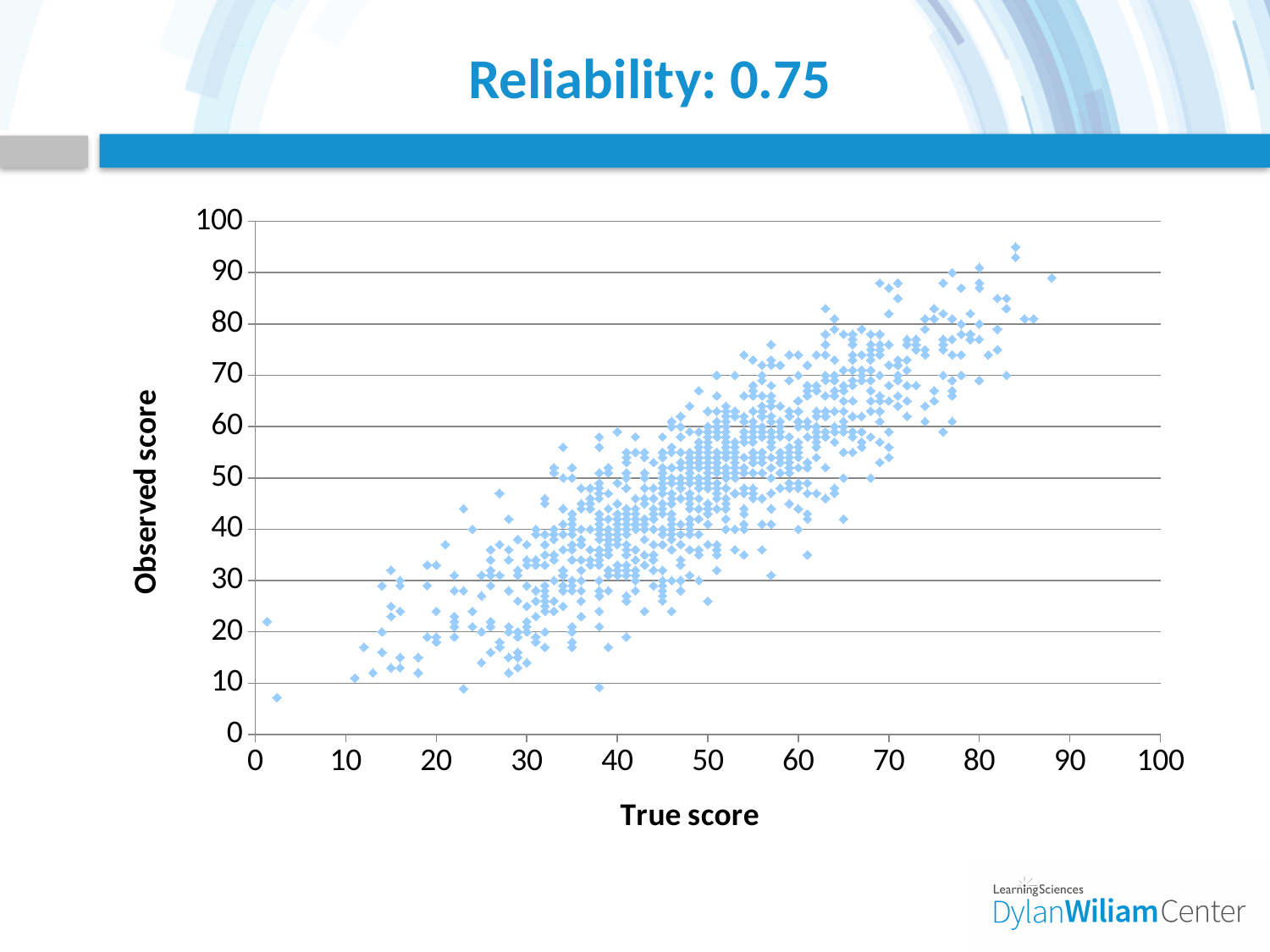
What is the highest tick value shown on the x axis (True score)? 100 What is the label of the vertical axis of the chart? Observed score What is the title of the chart on the slide? Reliability: 0.75 What kind of chart is shown on the slide? scatter plot What is the lowest tick value shown on the y axis (Observed score)? 0 As the true score increases along the x axis, does the observed score generally rise or fall? rise